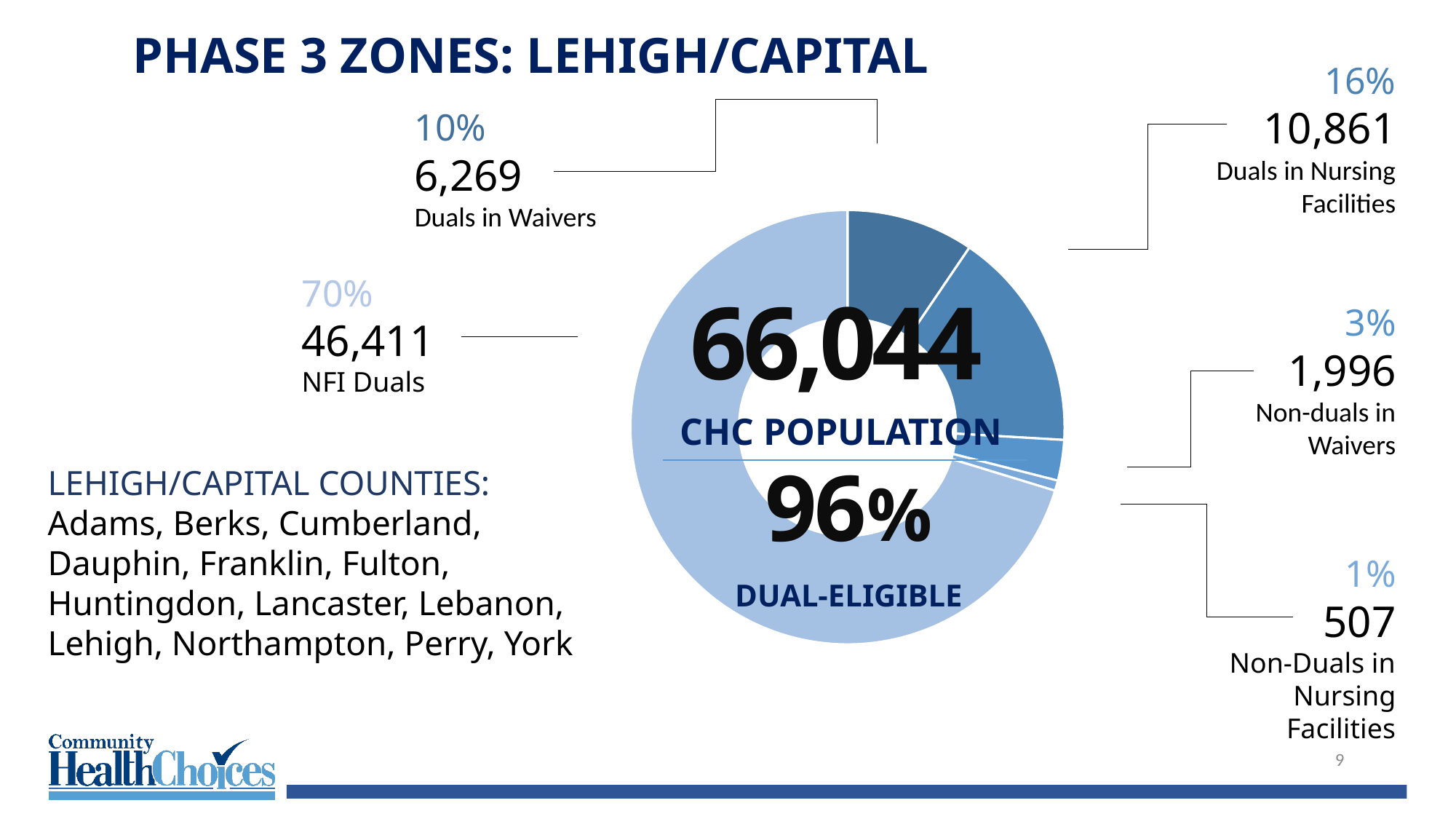
What is the difference between Duals in Nursing Facilities and Duals in Waivers? 4,592 What share of the chart do Duals in Waivers represent? 10% Which segment is the largest? NFI Duals What kind of chart is shown on the slide? Pie chart (donut) Which segment is the smallest? Non-Duals in Nursing Facilities What is the value for Non-Duals in Nursing Facilities? 507 What is the value for Duals in Nursing Facilities? 10,861 How many segments does the donut chart have? 5 Which is larger, Non-duals in Waivers or Non-Duals in Nursing Facilities? Non-duals in Waivers What is the value for NFI Duals? 46,411 What total CHC population is shown in the center of the chart? 66,044 What share of the chart do Non-duals in Waivers represent? 3%